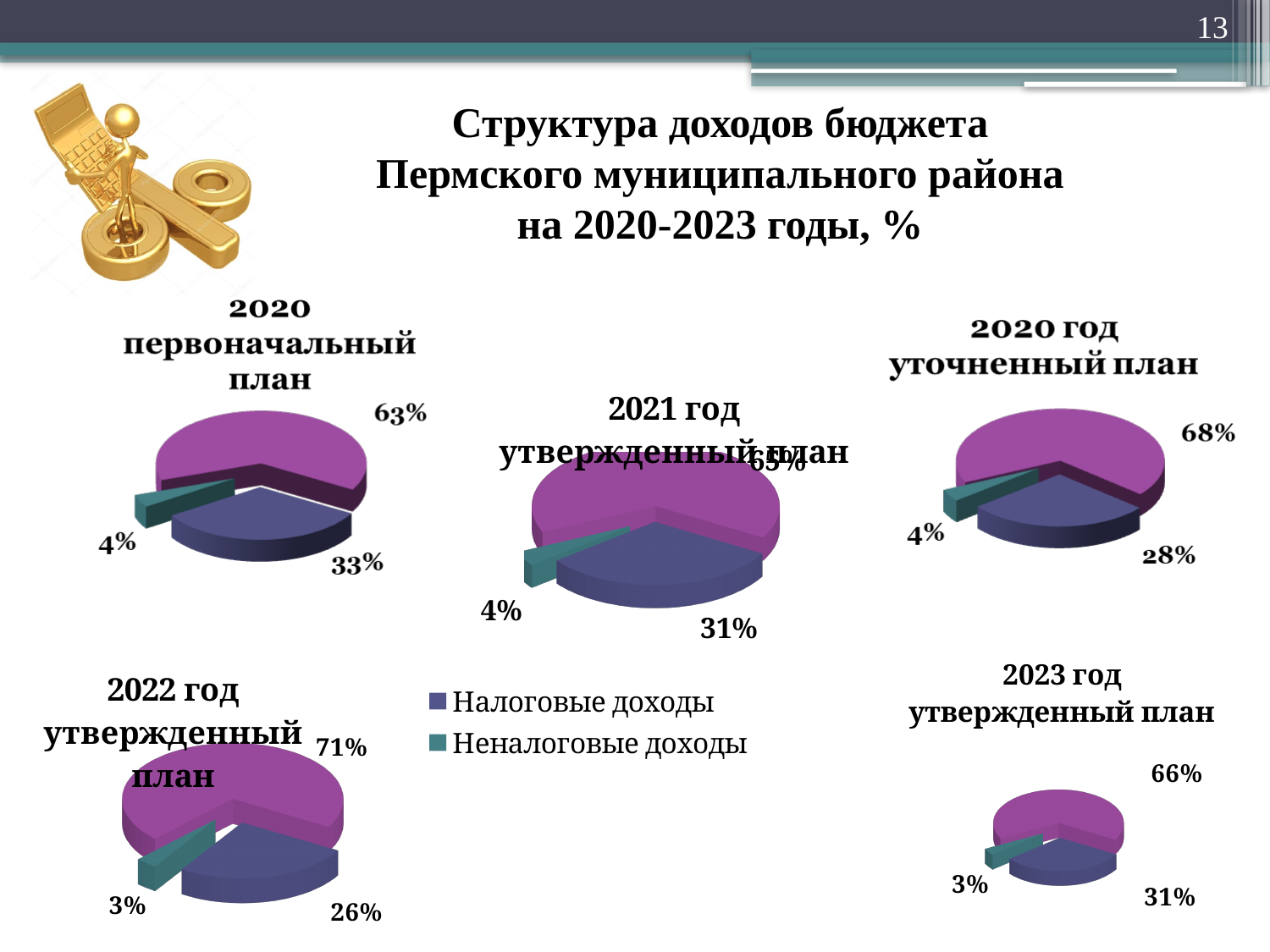
In the '2022 год утвержденный план' chart, what is the value for Неналоговые доходы? 3% In the '2020 год уточненный план' chart, what is the value for Налоговые доходы? 28% What is the smallest value shown in the '2020 год уточненный план' chart? 4% What kind of chart is used on this slide? Pie chart What is the largest value shown in the '2022 год утвержденный план' chart? 71% How many pie charts are shown on the slide? 5 In the '2020 первоначальный план' chart, what is the value for Налоговые доходы? 33% In the '2021 год утвержденный план' chart, what is the value for Неналоговые доходы? 4% Which is larger: Налоговые доходы in the '2020 первоначальный план' chart or in the '2022 год утвержденный план' chart? 2020 первоначальный план What is the difference between Налоговые доходы in the '2020 первоначальный план' chart and in the '2020 год уточненный план' chart? 5% In the '2023 год утвержденный план' chart, what is the value for Налоговые доходы? 31% How many entries does the legend list? 2